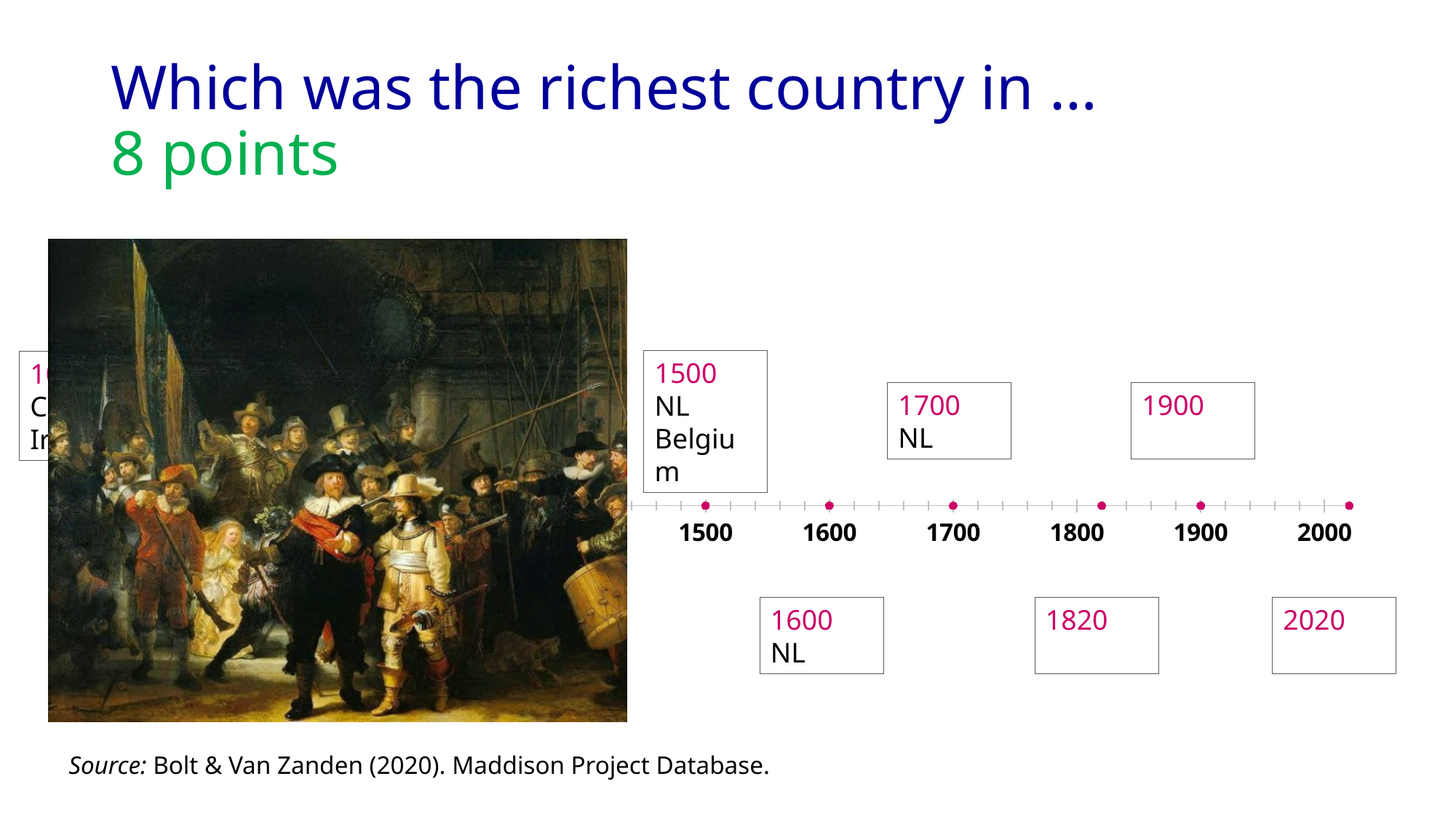
What kind of chart is shown on the slide? A timeline (scatter of points along a year axis) What is the latest year labelled on the timeline axis? 2000 What is the source cited for the timeline data? Bolt & Van Zanden (2020). Maddison Project Database. What is the earliest year labelled on the timeline axis? 1500 Which country is labelled as richest at the 1700 point on the timeline? NL Which country is labelled as richest at the 1600 point on the timeline? NL Which countries are listed in the 1500 label box on the timeline? NL, Belgium What year is shown in the label box between the 1700 and 1900 boxes? 1820 Which label boxes on the timeline have no country filled in? 1820, 1900, 2020